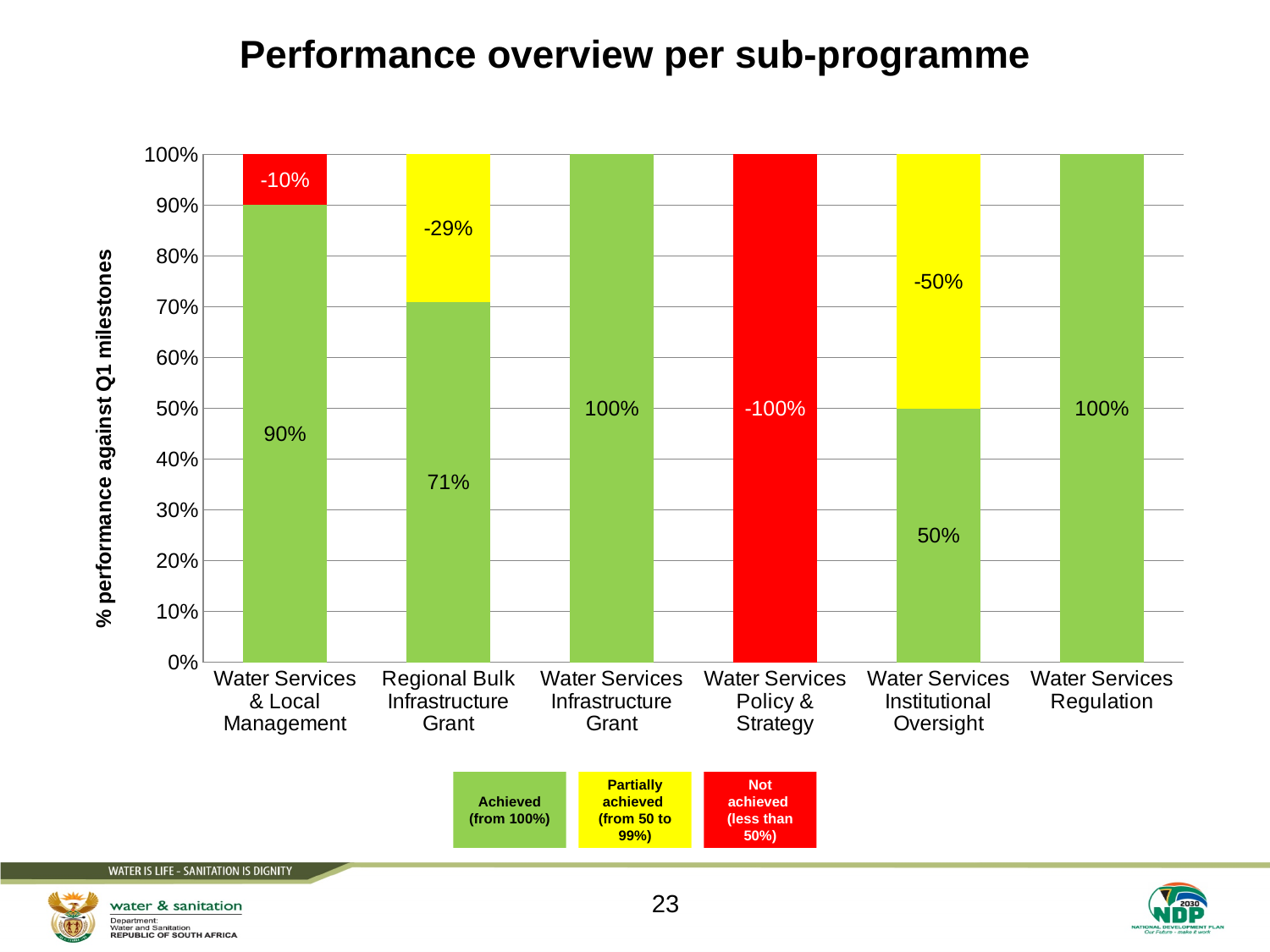
What value is labelled on the red segment for Water Services & Local Management? -10% How many categories does the legend list? 3 What value is labelled on the yellow segment for Water Services Institutional Oversight? -50% What is the label of the vertical axis? % performance against Q1 milestones Which sub-programme has the lowest achieved percentage? Water Services Policy & Strategy What is the difference in percentage points between the achieved values for Water Services & Local Management and Regional Bulk Infrastructure Grant? 19 percentage points How many sub-programmes are shown on the x axis? 6 Which has a higher achieved percentage, Regional Bulk Infrastructure Grant or Water Services Institutional Oversight? Regional Bulk Infrastructure Grant What value is labelled on the red segment for Water Services Policy & Strategy? -100% What is the achieved percentage for Regional Bulk Infrastructure Grant? 71% What is the achieved percentage for Water Services & Local Management? 90% What kind of chart is shown on the slide? Stacked bar chart